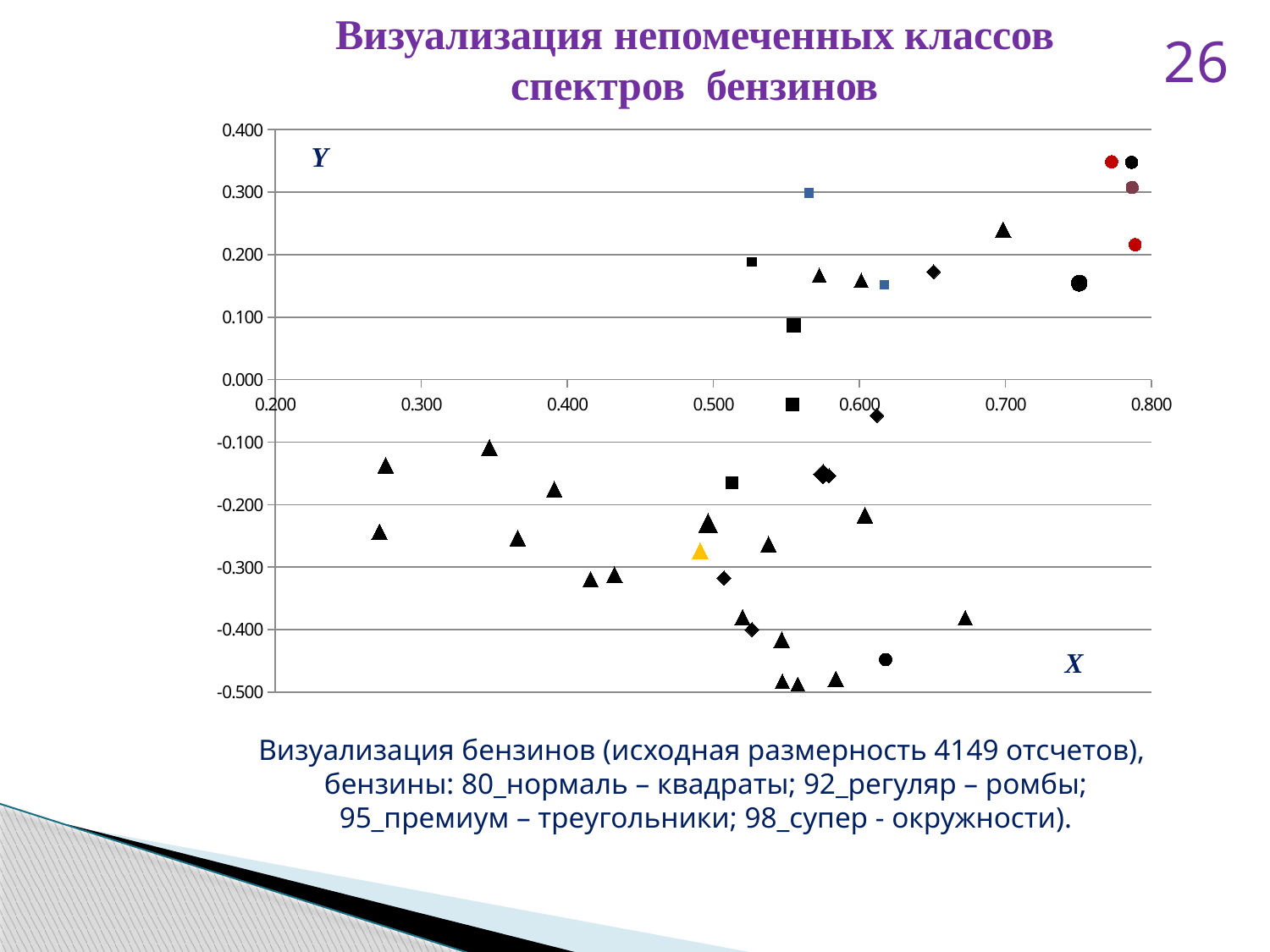
What is the title of the chart on the slide? Визуализация непомеченных классов спектров бензинов Are the X values of the red circle markers greater or less than 0.700? greater According to the caption, which marker shape represents the 80_нормаль gasoline class? Squares (квадраты) Which marker shape has the lowest Y value on the chart? Triangle Is the Y value of the yellow triangle marker greater or less than -0.200? less Which has the larger Y value: the blue square marker near the top or the black diamond marker near X = 0.650? The blue square marker What kind of chart is shown on the slide? Scatter chart Is the Y value of the leftmost triangle markers (near X = 0.270) greater or less than 0.000? less How many gasoline classes (marker shapes) does the caption list for the chart? 4 Which marker shape has the highest Y value on the chart? Circle